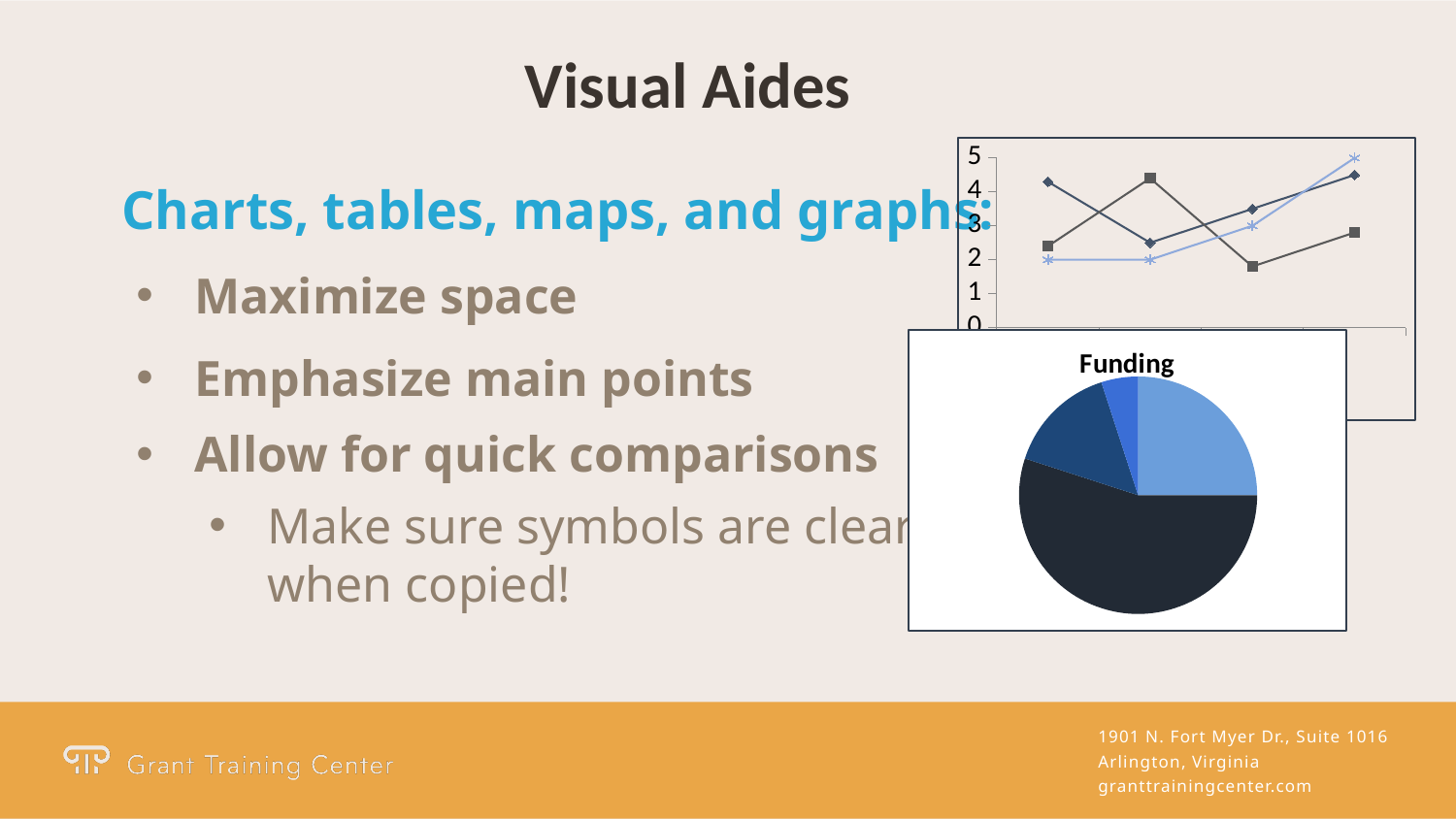
In the "Funding" pie chart, does the largest slice cover more or less than half of the pie? more What is the highest value shown on the y axis of the line chart in the top right of the slide? 5 On the line chart in the top right of the slide, does the line with asterisk markers rise or fall from its first point to its last point? rise In the "Funding" pie chart, which slice is the largest? the dark navy slice In the "Funding" pie chart, which slice is the smallest? the bright blue slice How many slices does the "Funding" pie chart have? 4 How many lines are plotted on the line chart in the top right of the slide? 3 On the line chart in the top right of the slide, is the last point of the line with asterisk markers greater or less than 4? greater What is the title of the pie chart on the slide? Funding What kind of chart is the chart titled "Funding"? pie chart What kind of chart is the chart in the top right of the slide? line chart How many data points does each line have on the line chart in the top right of the slide? 4